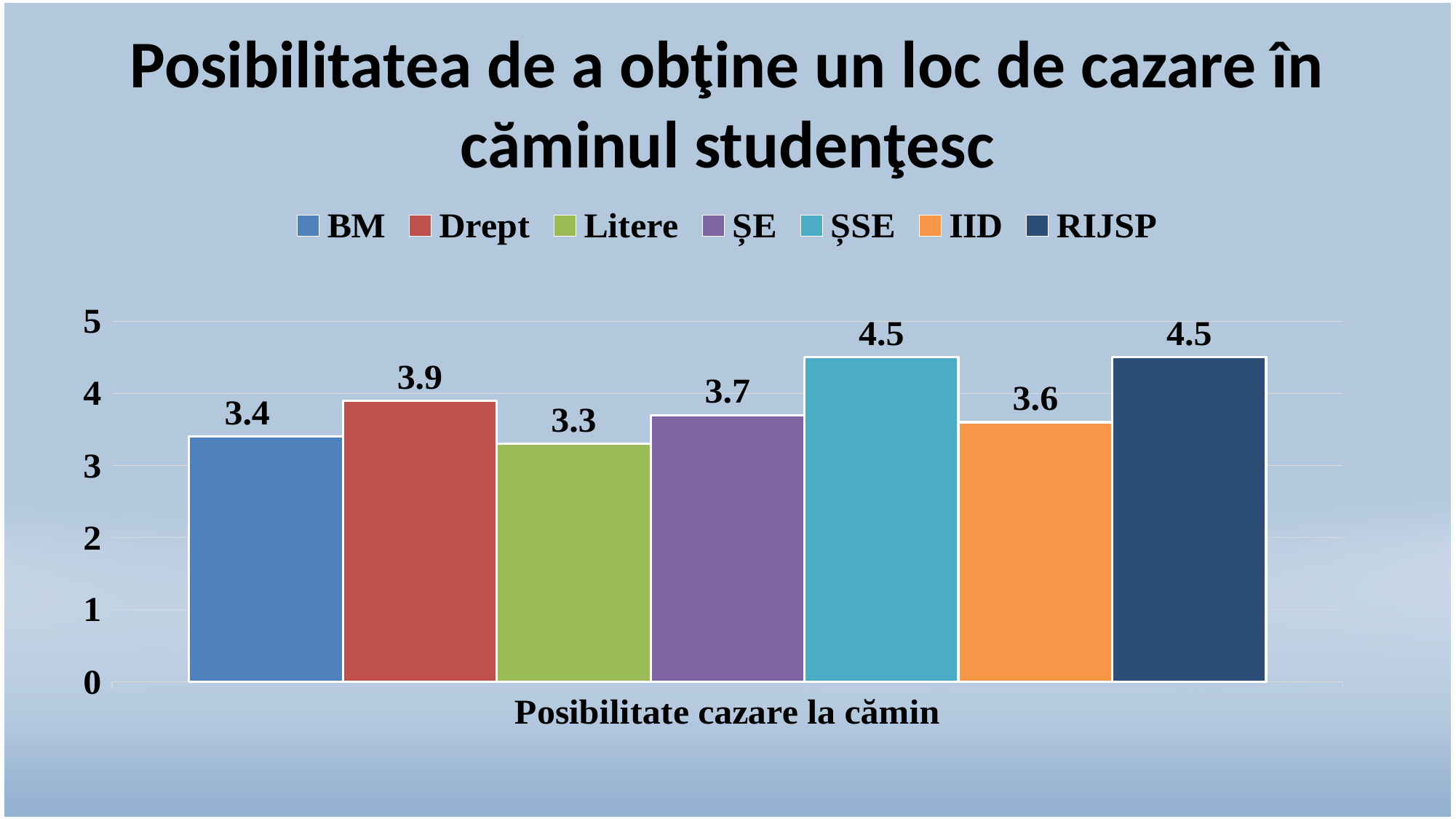
How many series does the legend list? 7 What is the value for Drept? 3.9 Which is larger, the value for Drept or the value for IID? Drept Is the value for RIJSP greater or less than 4? greater What is the value for ȘE? 3.7 What is the value for IID? 3.6 What is the label shown on the x axis below the bars? Posibilitate cazare la cămin What kind of chart is shown on the slide? bar chart What is the difference between the values for Drept and BM? 0.5 Which series has the lowest value? Litere What is the value for BM? 3.4 What is the difference between the values for ȘSE and Litere? 1.2